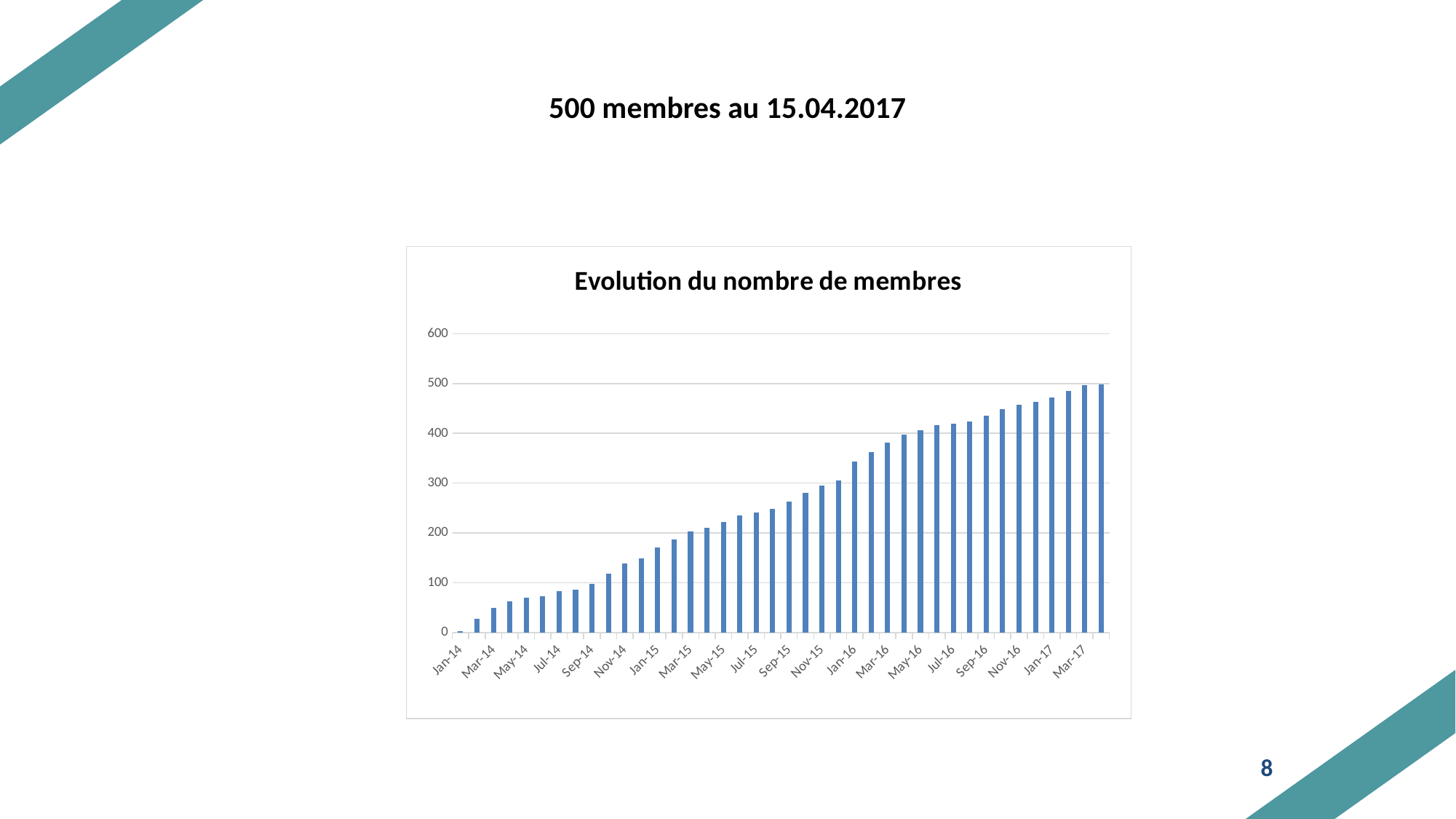
What kind of chart is shown on the slide? bar chart Is the value for Jan-17 greater or less than 500? less Is the value for Nov-16 greater or less than 400? greater Is the value for Jan-16 greater or less than 300? greater Which month has the lowest value in the chart? Jan-14 What colour are the bars in the chart? blue What is the title of the chart? Evolution du nombre de membres Do the values in the chart rise or fall from Jan-14 to Mar-17? rise Which is larger, the value for Jan-15 or the value for Jan-16? Jan-16